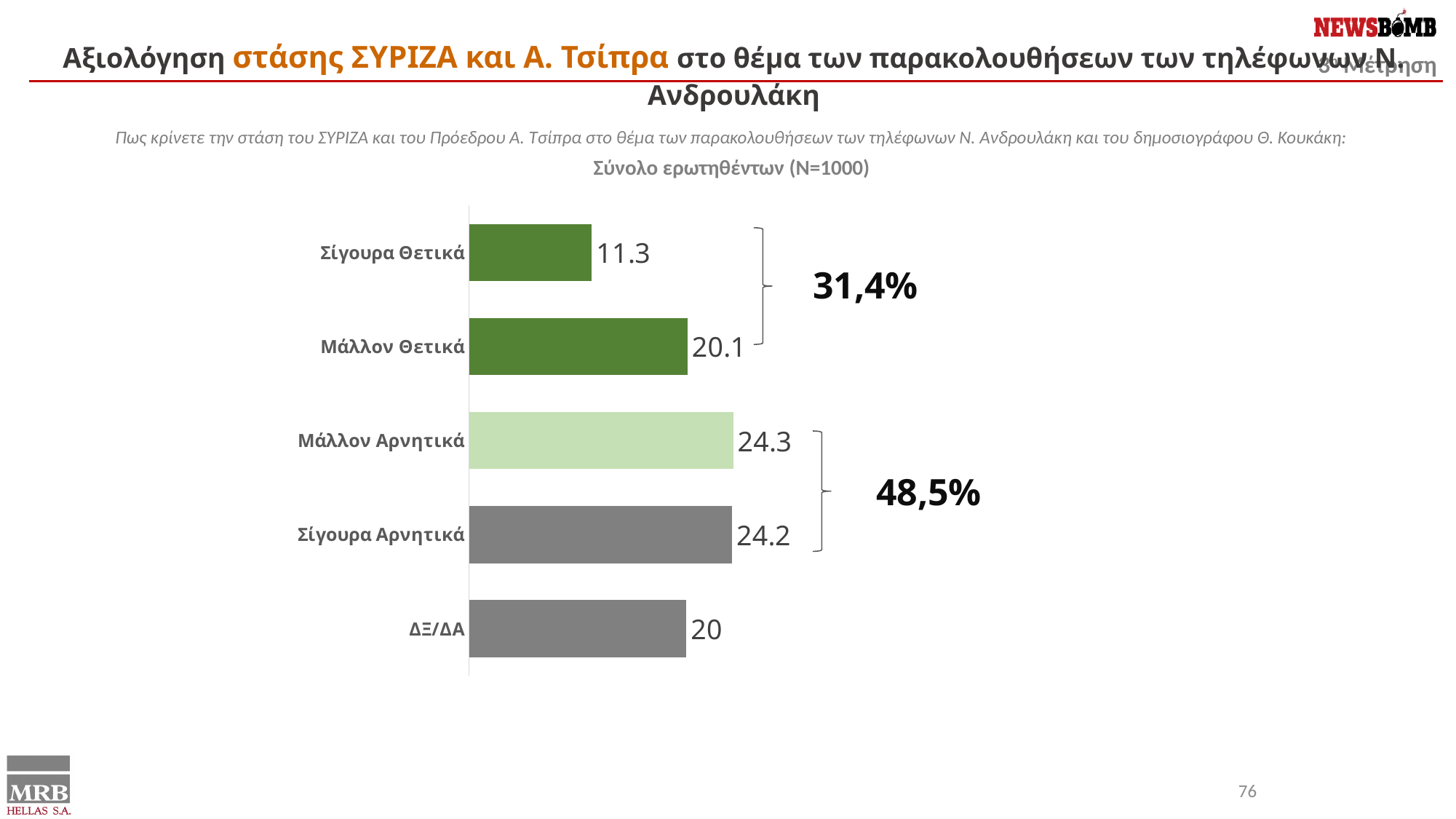
What combined percentage is shown for the two positive categories (Σίγουρα Θετικά and Μάλλον Θετικά)? 31,4% What is the value for Σίγουρα Θετικά? 11.3 What kind of chart is shown on the slide? bar chart How many categories (bars) does the chart show? 5 Which category has the lowest value? Σίγουρα Θετικά What sample size (N) is stated above the chart? N=1000 What is the value for Μάλλον Αρνητικά? 24.3 What is the value for ΔΞ/ΔΑ? 20 What is the difference between the values for Μάλλον Αρνητικά and Σίγουρα Θετικά? 13 What is the value for Μάλλον Θετικά? 20.1 Which is larger, the value for Σίγουρα Θετικά or the value for Μάλλον Θετικά? Μάλλον Θετικά What is the value for Σίγουρα Αρνητικά? 24.2